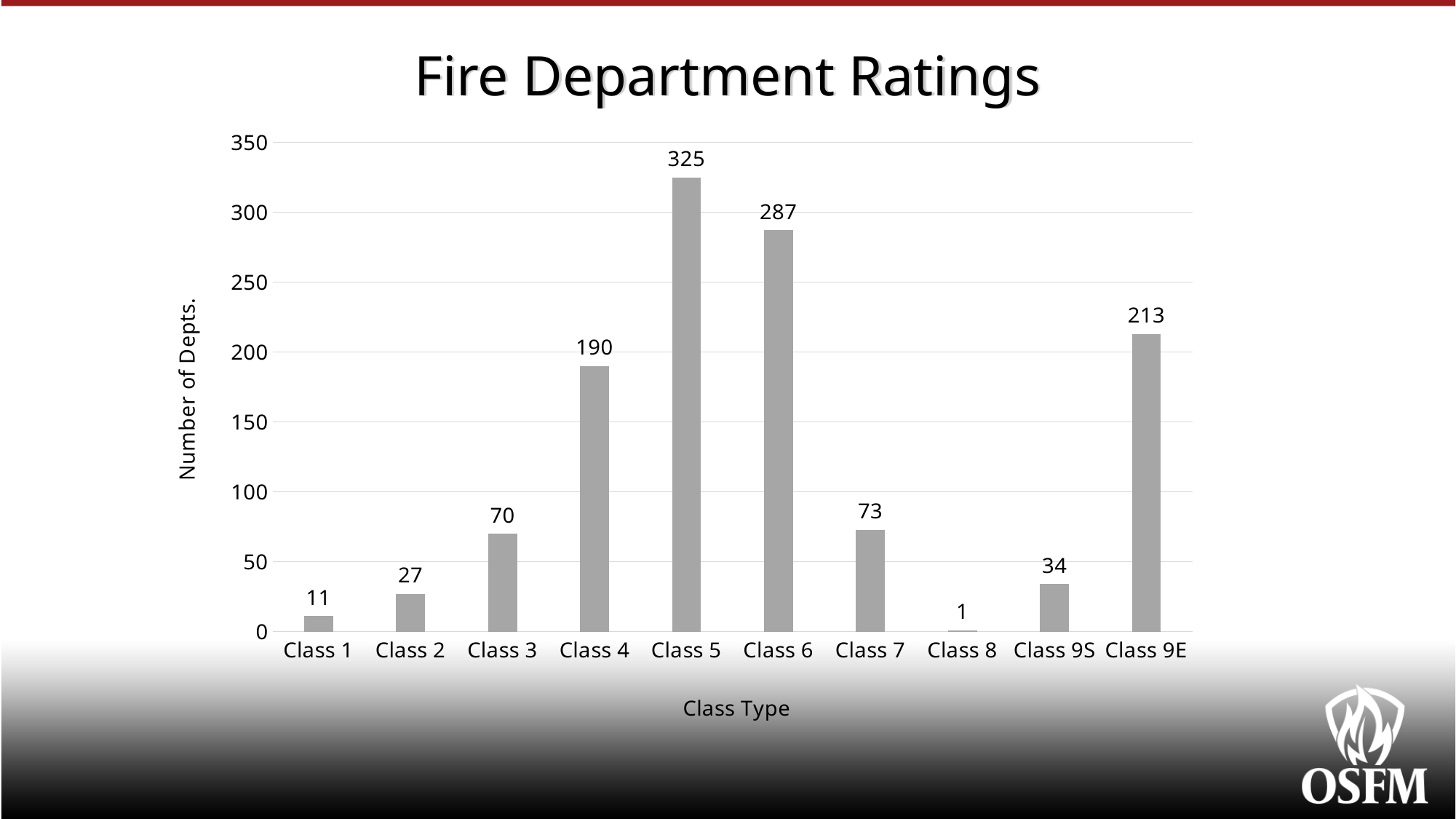
Is the value for Class 6 greater or less than 250? greater How many class types are shown on the x axis? 10 Which class type has the lowest number of departments? Class 8 What is the number of departments for Class 2? 27 What kind of chart is shown on the slide? Bar chart Which class type has the highest number of departments? Class 5 What is the number of departments for Class 5? 325 What is the number of departments for Class 9E? 213 What is the difference in number of departments between Class 5 and Class 6? 38 What is the title of the chart? Fire Department Ratings What is the difference in number of departments between Class 9E and Class 4? 23 Which has more departments, Class 3 or Class 7? Class 7